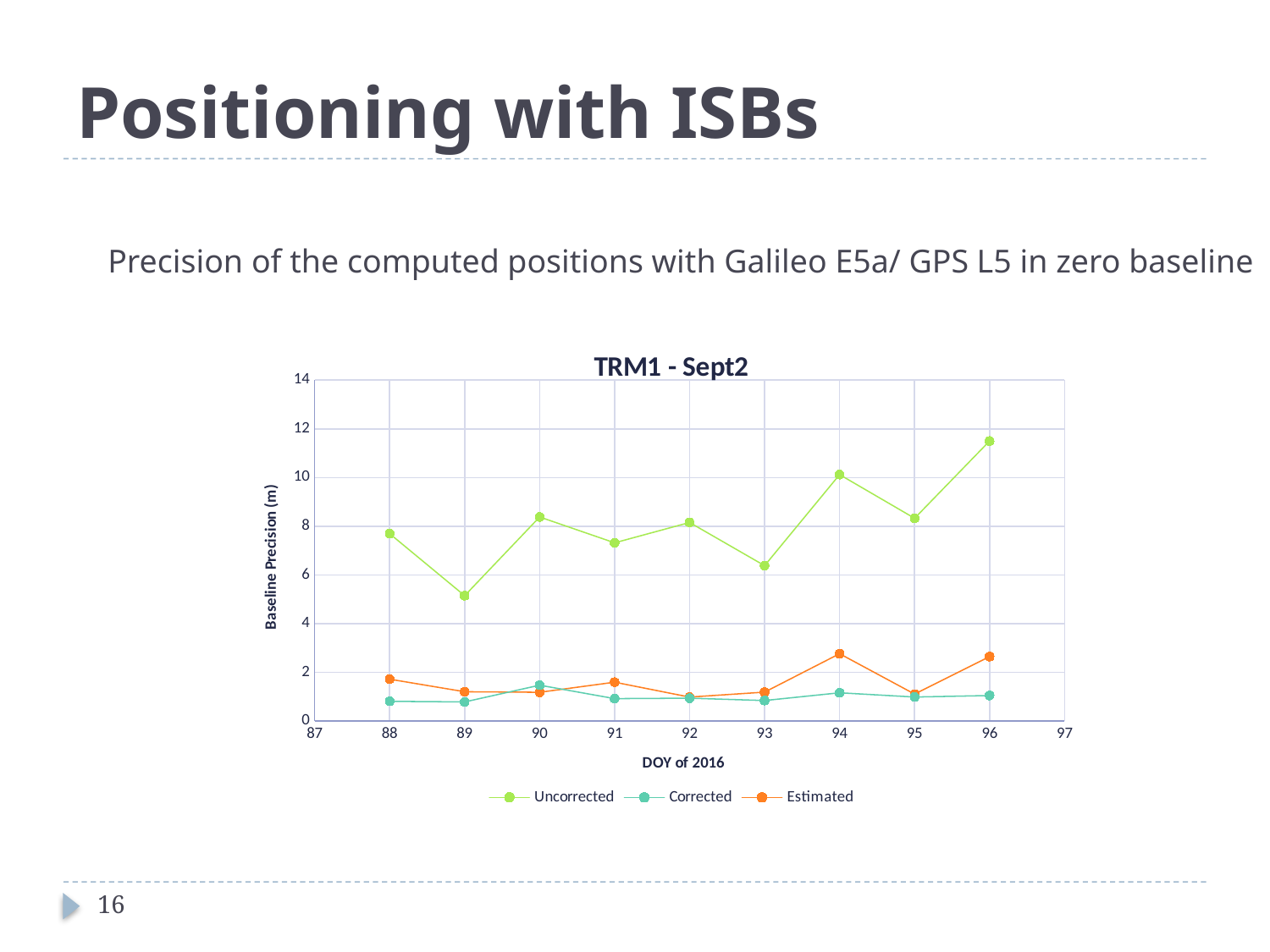
Is the Uncorrected value at DOY 96 greater or less than 10? greater How many data points does the Uncorrected series have? 9 How many series does the legend list? 3 Which series are listed in the legend? Uncorrected, Corrected, Estimated At which DOY is the Uncorrected baseline precision highest? 96 Is the Estimated value at DOY 94 greater or less than 2? greater Is the Uncorrected value at DOY 89 greater or less than 6? less What kind of chart is shown on the slide? line chart Which is larger, the Uncorrected value at DOY 94 or at DOY 95? DOY 94 At which DOY is the Uncorrected baseline precision lowest? 89 What is the title of the chart? TRM1 - Sept2